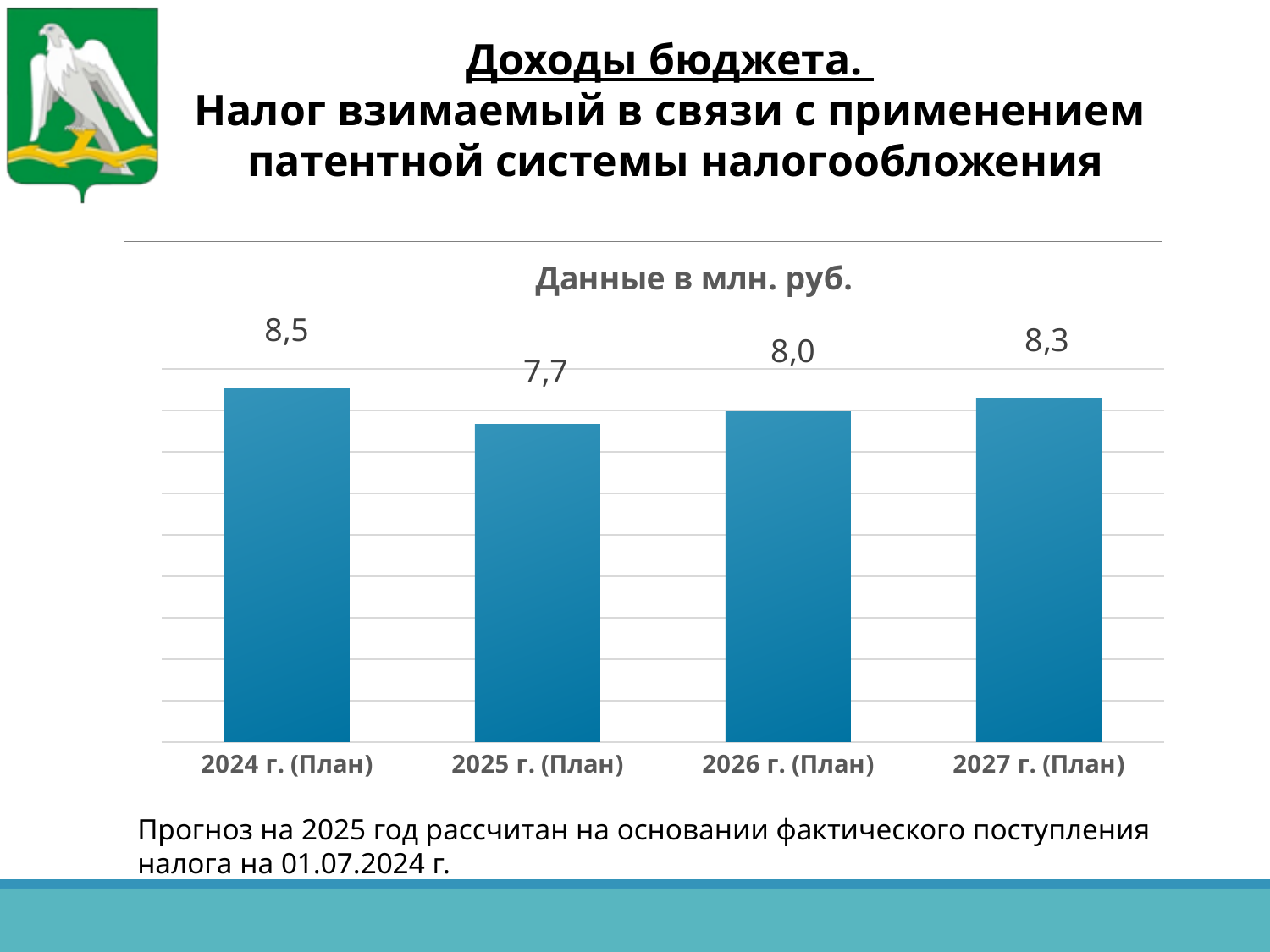
What is the difference between the values for 2024 г. (План) and 2025 г. (План)? 0,8 What is the value for 2025 г. (План)? 7,7 What is the difference between the values for 2027 г. (План) and 2026 г. (План)? 0,3 What is the chart's title? Данные в млн. руб. How many categories are shown on the chart? 4 Which is larger, the value for 2026 г. (План) or 2027 г. (План)? 2027 г. (План) What kind of chart is shown on the slide? Bar chart What is the value for 2024 г. (План)? 8,5 Which year has the highest value? 2024 г. (План) What is the value for 2027 г. (План)? 8,3 Which year has the lowest value? 2025 г. (План) What is the value for 2026 г. (План)? 8,0